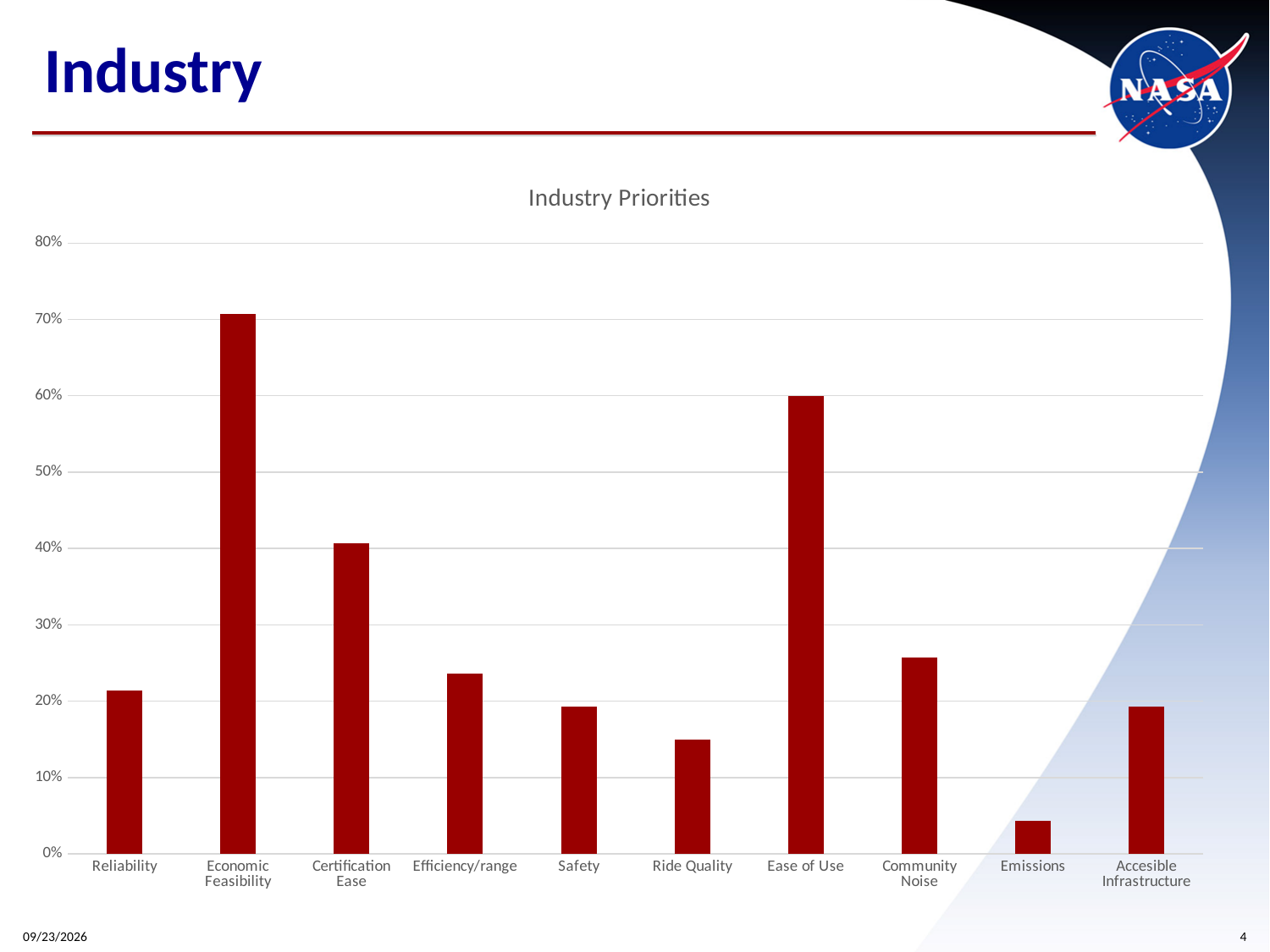
Is the value for Certification Ease greater or less than 50%? less What is the title of the chart? Industry Priorities Which category has the highest value in the chart? Economic Feasibility Which has a higher value, Reliability or Ride Quality? Reliability Is the value for Emissions greater or less than 10%? less Is the value for Community Noise greater or less than 20%? greater How many categories are shown on the x axis of the chart? 10 What kind of chart is shown on the slide? bar chart Which category has the lowest value in the chart? Emissions Which has a higher value, Ease of Use or Certification Ease? Ease of Use